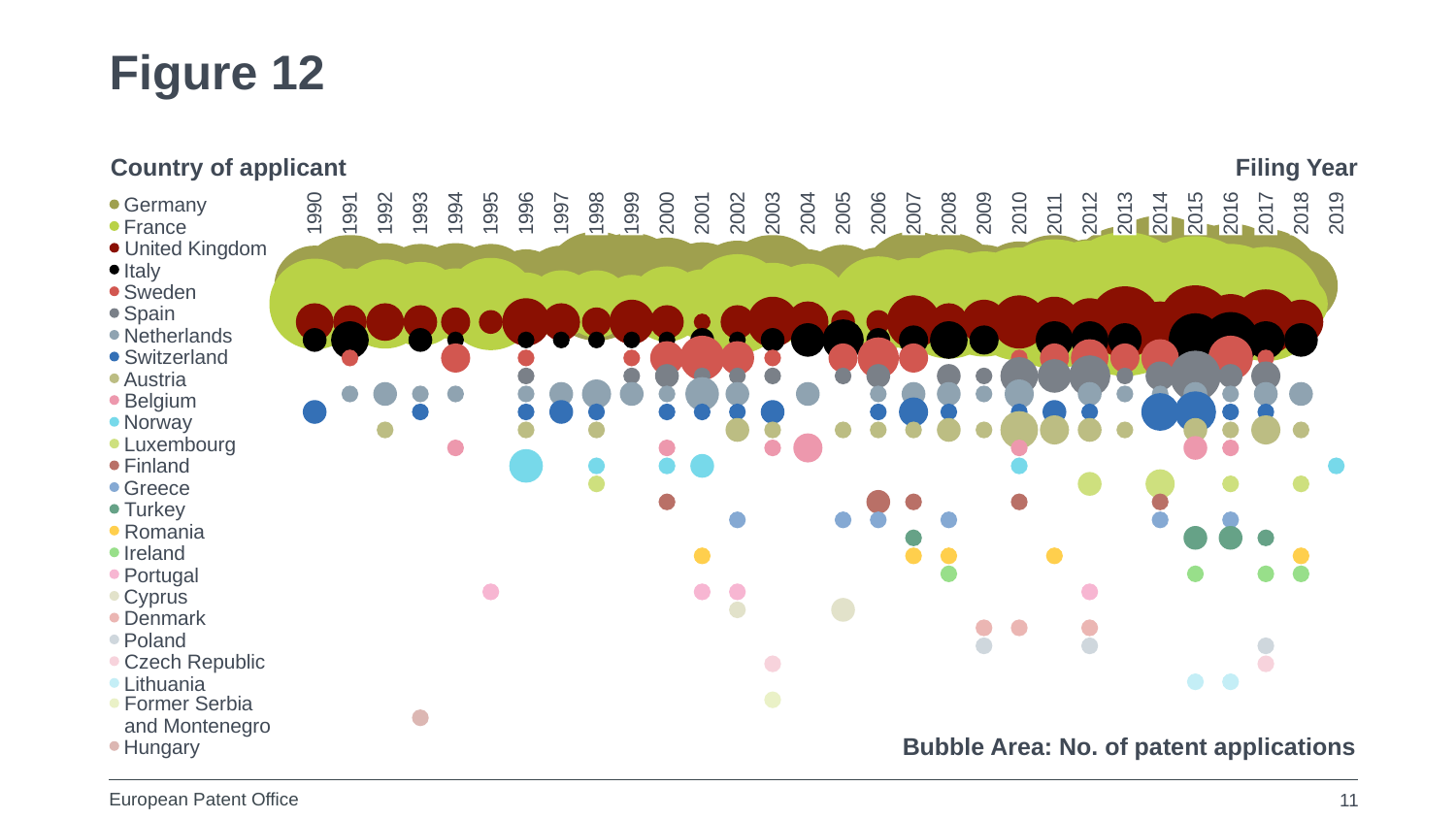
How many filing years are shown along the x axis? 30 In 1993, which country has the larger bubble, Germany or Hungary? Germany In 2015, which country has the larger bubble, France or Lithuania? France According to the slide, what does the bubble area represent? No. of patent applications What is the latest filing year shown on the x axis? 2019 Which country is listed first in the legend? Germany How many countries does the legend list? 25 In 2003, which country has the larger bubble, United Kingdom or Czech Republic? United Kingdom What kind of chart is shown on the slide? Bubble chart What is the earliest filing year shown on the x axis? 1990